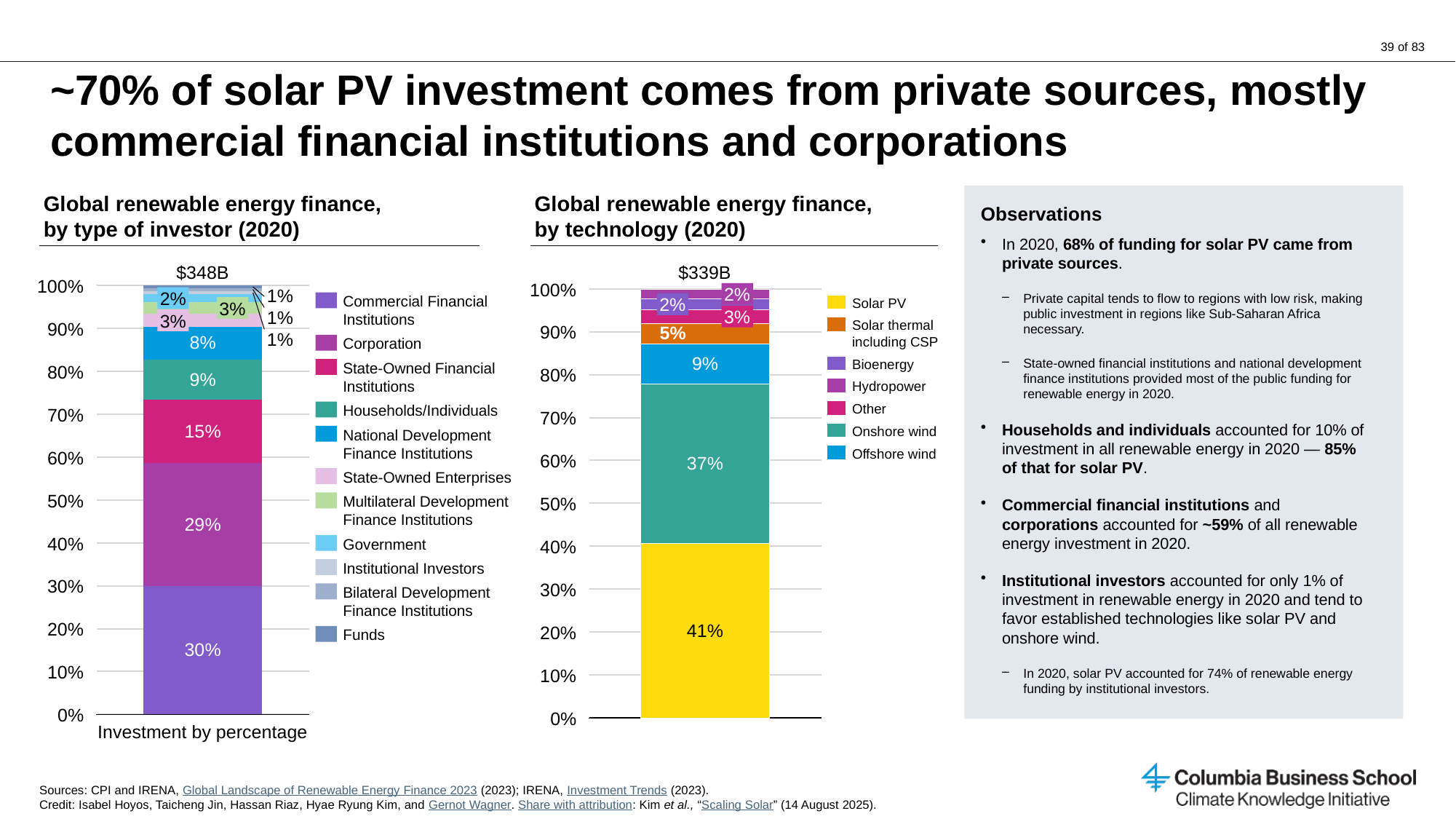
In the chart 'Global renewable energy finance, by technology (2020)', which is larger, Offshore wind or Solar thermal including CSP? Offshore wind In the chart 'Global renewable energy finance, by technology (2020)', what is the difference in percentage points between Solar PV and Onshore wind? 4 percentage points In the chart 'Global renewable energy finance, by type of investor (2020)', what percentage is shown for Corporation? 29% In the chart 'Global renewable energy finance, by technology (2020)', what percentage is shown for Solar PV? 41% In the chart 'Global renewable energy finance, by type of investor (2020)', which investor type has the largest share? Commercial Financial Institutions In the chart 'Global renewable energy finance, by type of investor (2020)', what percentage is shown for Commercial Financial Institutions? 30% What kind of chart is 'Global renewable energy finance, by technology (2020)'? Stacked bar chart In the chart 'Global renewable energy finance, by type of investor (2020)', what is the difference in percentage points between State-Owned Financial Institutions and National Development Finance Institutions? 7 percentage points In the chart 'Global renewable energy finance, by type of investor (2020)', what percentage is shown for Households/Individuals? 9% How many investor types does the legend of the chart 'Global renewable energy finance, by type of investor (2020)' list? 11 In the chart 'Global renewable energy finance, by technology (2020)', what percentage is shown for Onshore wind? 37% In the chart 'Global renewable energy finance, by type of investor (2020)', what total value is printed above the bar? $348B